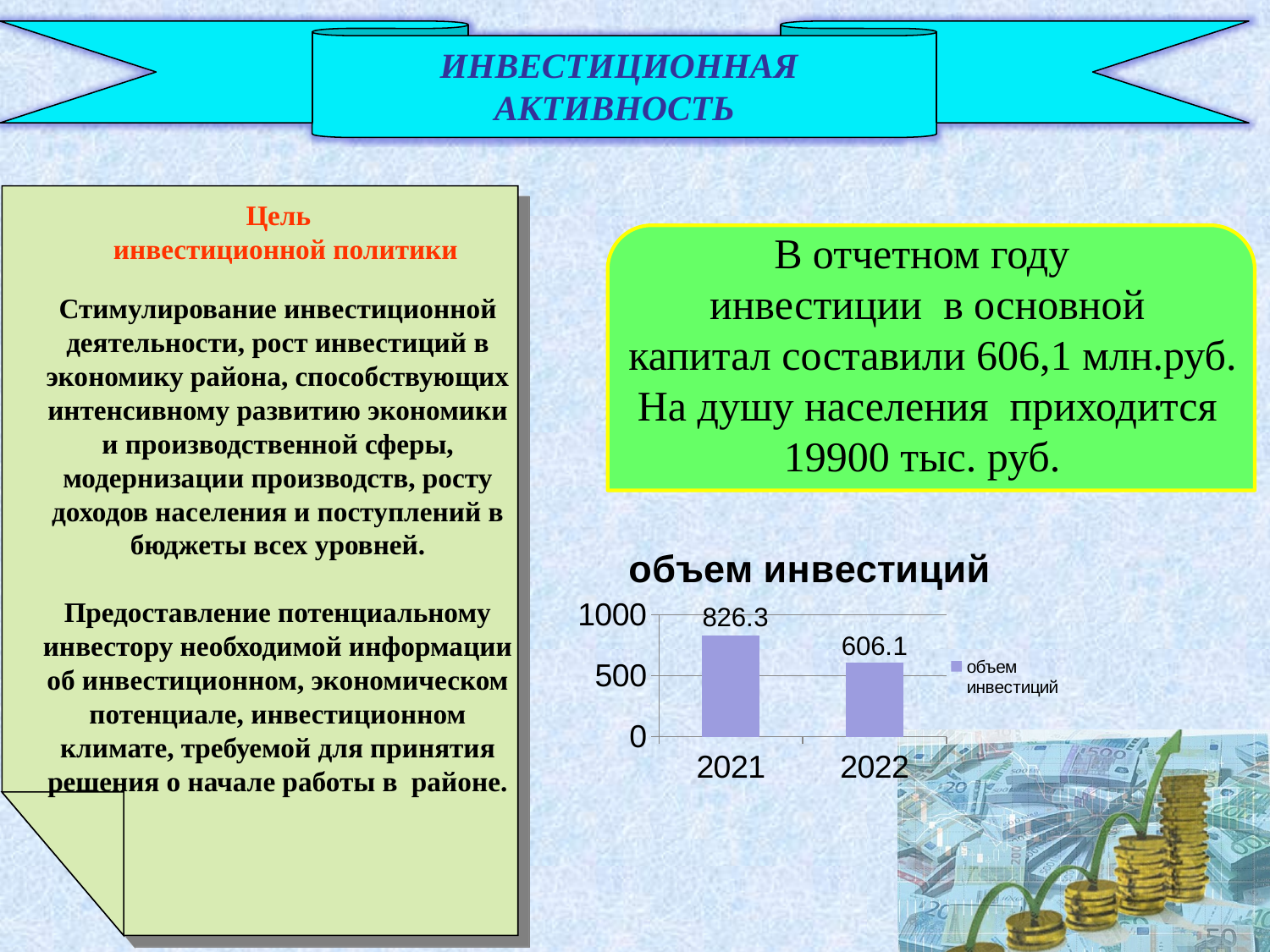
What is the difference between the values for 2021 and 2022? 220.2 Which year has the lowest value in the chart? 2022 Which year has the highest value in the chart? 2021 Is the value for 2022 greater or less than 1000? less What kind of chart is shown on the slide? bar chart What is the value for 2022 in the chart? 606.1 What is the value for 2021 in the chart? 826.3 How many series does the chart legend list? 1 How many years are shown on the x axis of the chart? 2 Is the value for 2021 greater or less than 500? greater Which is larger, the value for 2021 or the value for 2022? 2021 Do the values rise or fall from 2021 to 2022? fall